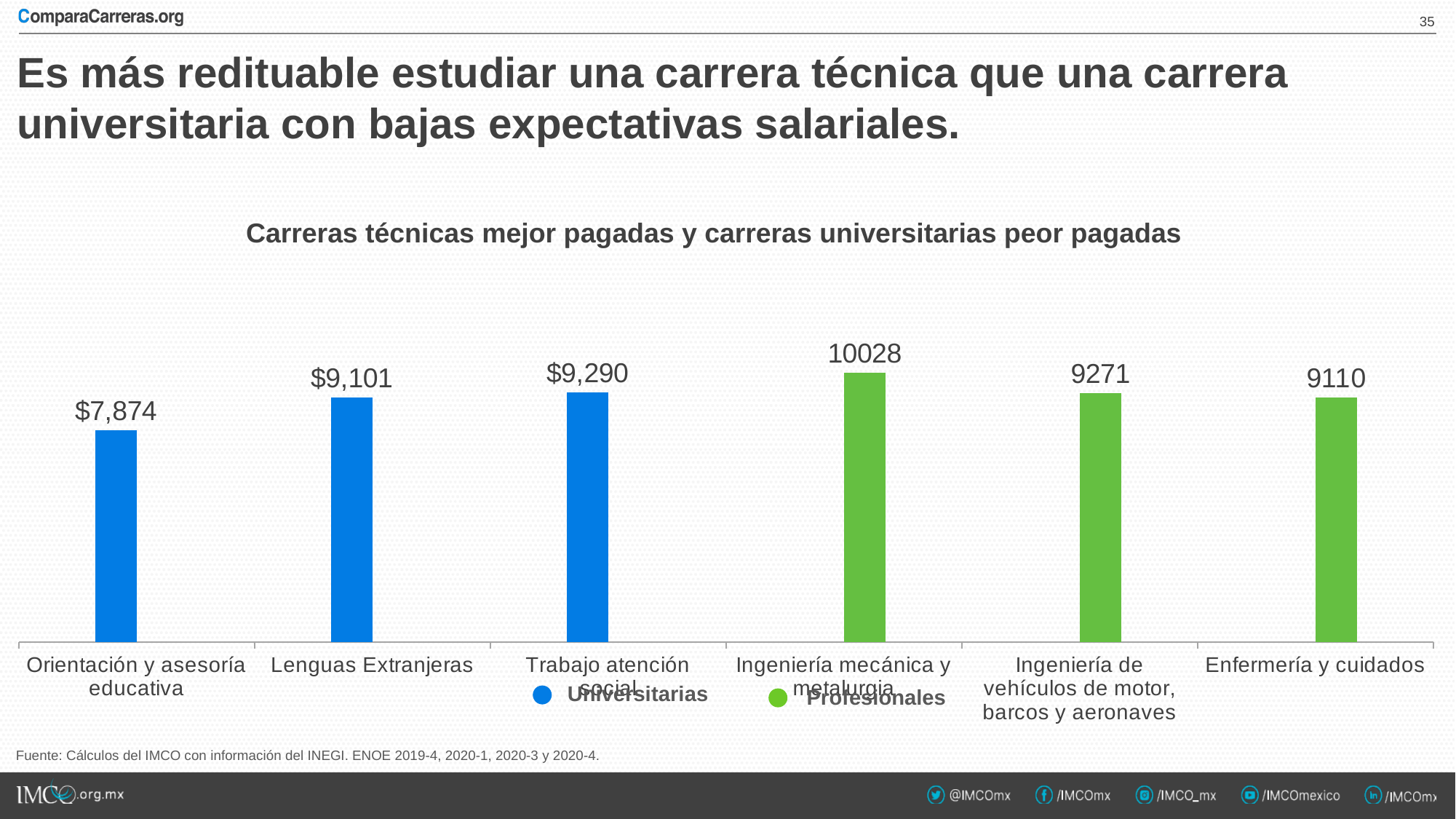
How many series does the legend list? 2 What is the value for Ingeniería de vehículos de motor, barcos y aeronaves? 9271 What is the value for Orientación y asesoría educativa? $7,874 What type of chart is shown on the slide? bar chart How many categories are shown in the chart? 6 What is the difference between Trabajo atención social and Lenguas Extranjeras? $189 What is the value for Ingeniería mecánica y metalurgia? 10028 What is the difference between Ingeniería mecánica y metalurgia and Enfermería y cuidados? 918 Which category has the lowest value? Orientación y asesoría educativa Which category has the highest value? Ingeniería mecánica y metalurgia What is the value for Enfermería y cuidados? 9110 What is the value for Lenguas Extranjeras? $9,101